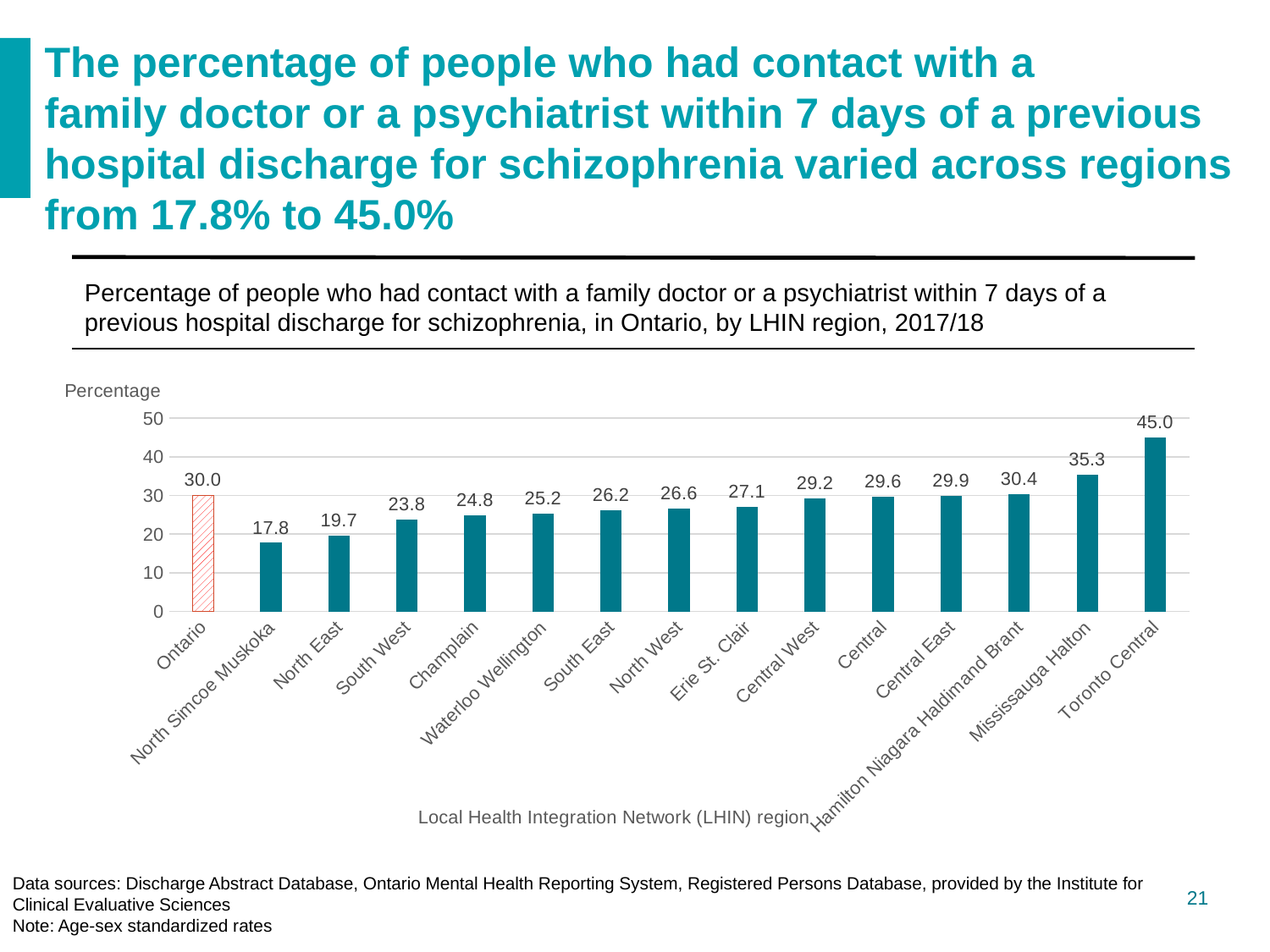
How many bars are shown in the chart? 15 Which LHIN region has the highest value? Toronto Central What is the difference between the values for Toronto Central and North Simcoe Muskoka? 27.2 What is the difference between the values for Hamilton Niagara Haldimand Brant and Ontario? 0.4 What is the label on the vertical axis of the chart? Percentage What is the value for Mississauga Halton? 35.3 Which is larger, the value for North East or the value for South West? South West Which LHIN region has the lowest value? North Simcoe Muskoka What is the value for Ontario? 30.0 What is the value for Champlain? 24.8 What kind of chart is shown on the slide? Bar chart Is the value for Erie St. Clair greater or less than 30? less